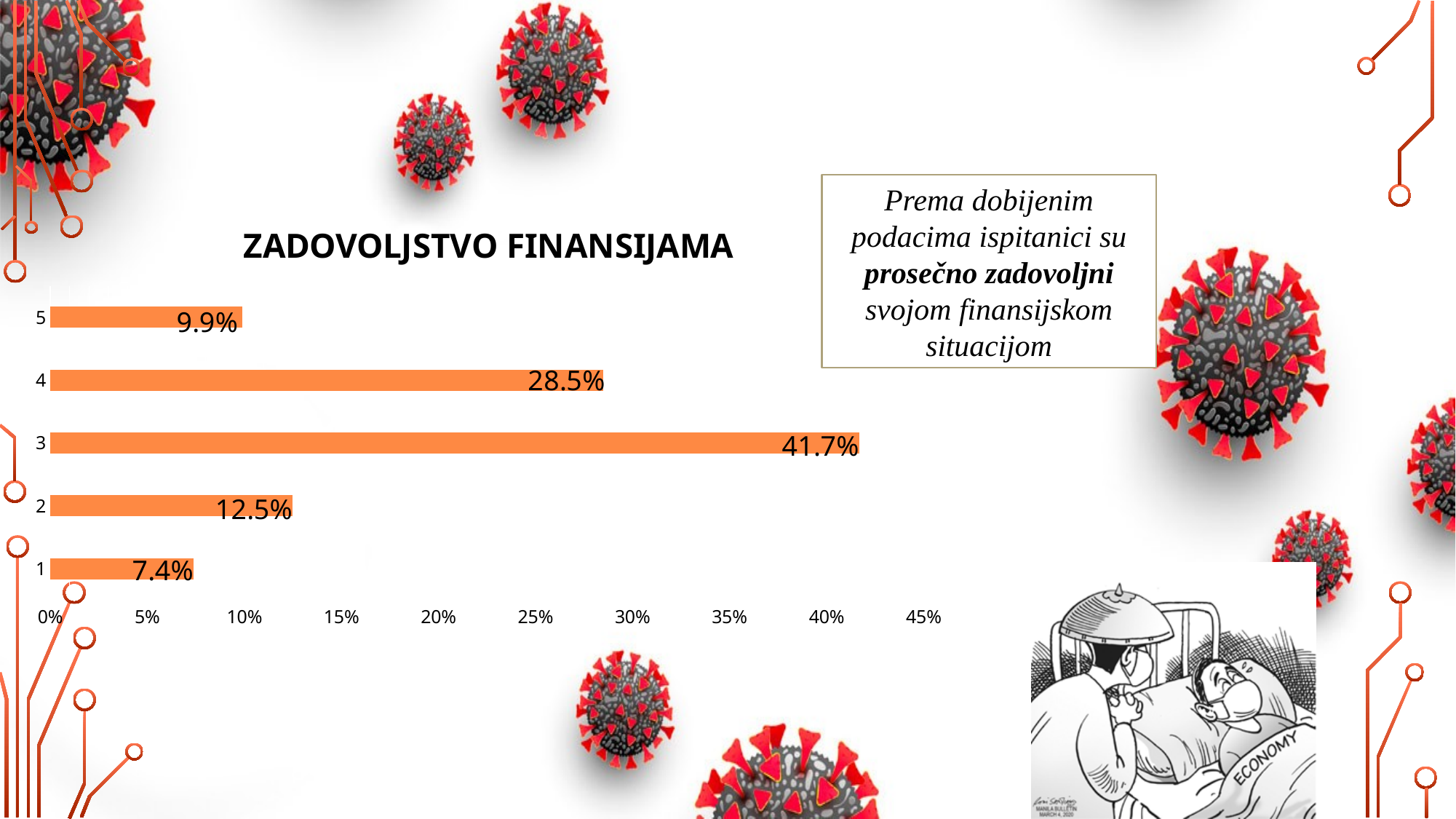
Which category has the lowest value? 1 What is the value for category 4? 28.5% What is the difference between the values for category 3 and category 4? 13.2% How many categories are shown in the chart? 5 What is the value for category 1? 7.4% Is the value for category 4 greater or less than 25%? greater What is the difference between the values for category 2 and category 5? 2.6% What is the value for category 3? 41.7% What kind of chart is shown on the slide? bar chart Which category has the highest value? 3 What is the title of the chart? ZADOVOLJSTVO FINANSIJAMA Which is larger, the value for category 2 or the value for category 5? 2